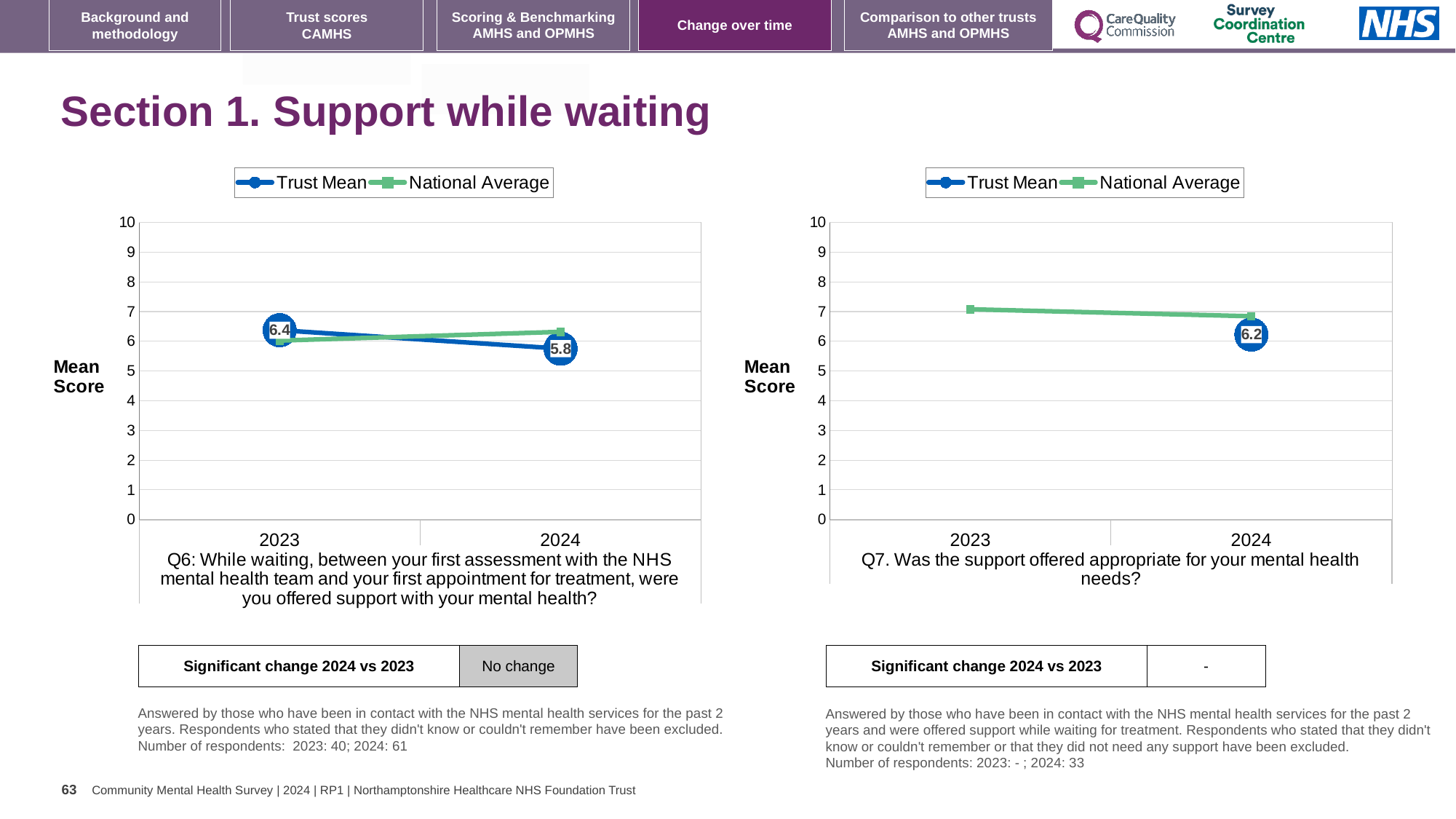
In the Q6 chart on the left, which year has the higher Trust Mean, 2023 or 2024? 2023 How many years are plotted on the x axis of the Q7 chart on the right? 2 In the Q6 chart on the left, what is the Trust Mean score for 2023? 6.4 In the Q6 chart on the left, by how much did the Trust Mean change from 2023 to 2024? 0.6 In the Q6 chart on the left, does the Trust Mean rise or fall from 2023 to 2024? fall How many series does the legend of the Q7 chart on the right list? 2 In the Q7 chart on the right, which is larger: the National Average for 2023 or the Trust Mean for 2024? National Average for 2023 What kind of chart is the Q6 chart on the left? line chart In the Q6 chart on the left, what is the Trust Mean score for 2024? 5.8 What are the two series named in the legend of the Q6 chart on the left? Trust Mean and National Average In the Q7 chart on the right, is the National Average for 2023 greater or less than 6? greater In the Q7 chart on the right, what is the Trust Mean score for 2024? 6.2